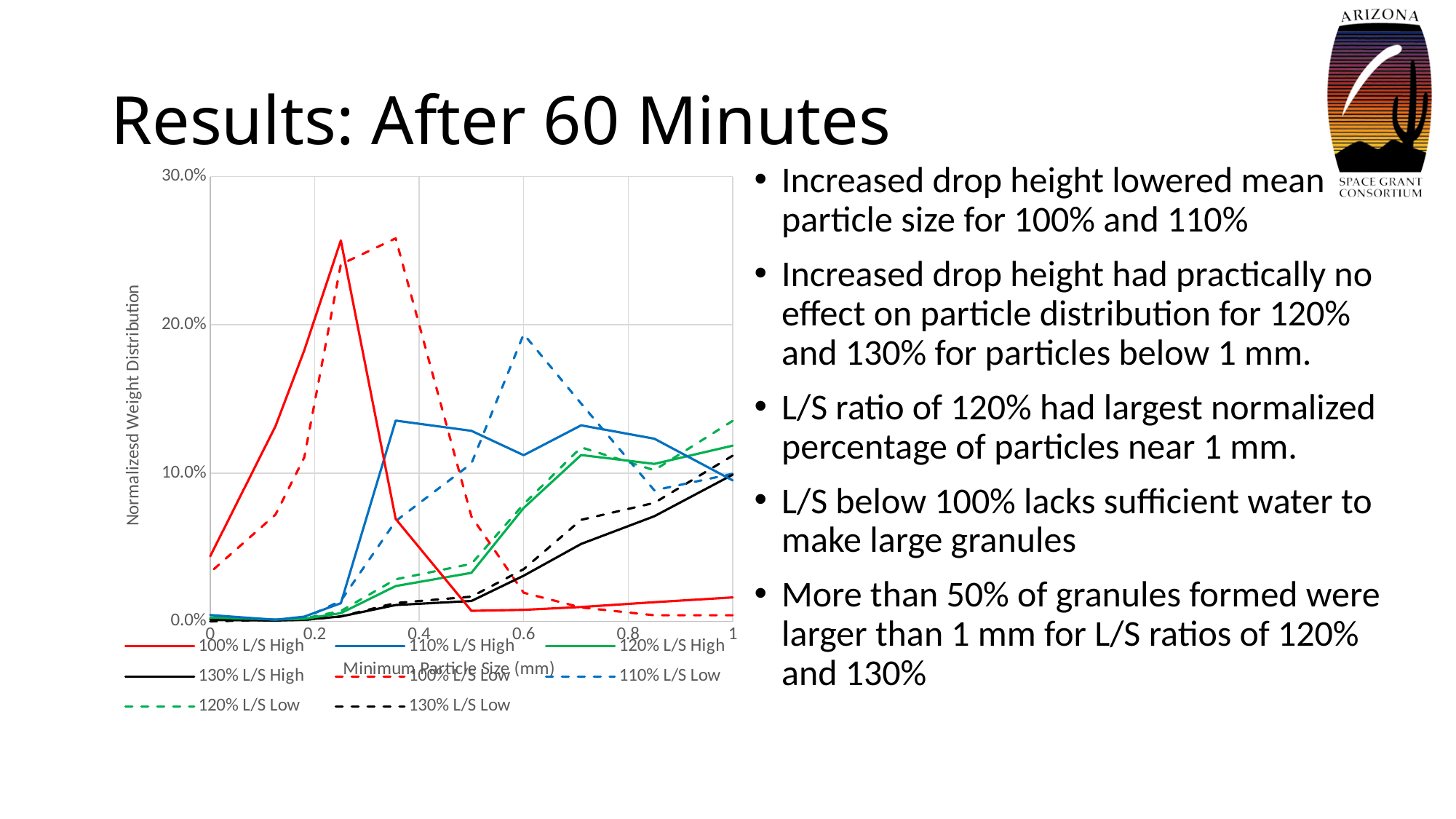
Does the 130% L/S High series generally rise or fall as minimum particle size increases from 0.4 mm to 1 mm? rise Is the value of the 110% L/S High series at a minimum particle size of 0.4 mm greater or less than 10.0%? greater What kind of chart is shown on the slide? line chart Is the peak value of the 100% L/S High series greater or less than 20.0%? greater At a minimum particle size of about 0.25 mm, which series has the larger value: 100% L/S High or 110% L/S High? 100% L/S High What is the title of the chart's y axis? Normalizesd Weight Distribution Is the value of the 100% L/S Low series at a minimum particle size of 0.8 mm greater or less than 10.0%? less What is the title of the chart's x axis? Minimum Particle Size (mm) Does the 100% L/S High series rise or fall as minimum particle size increases from 0.25 mm to 0.5 mm? fall How many series does the chart legend list? 8